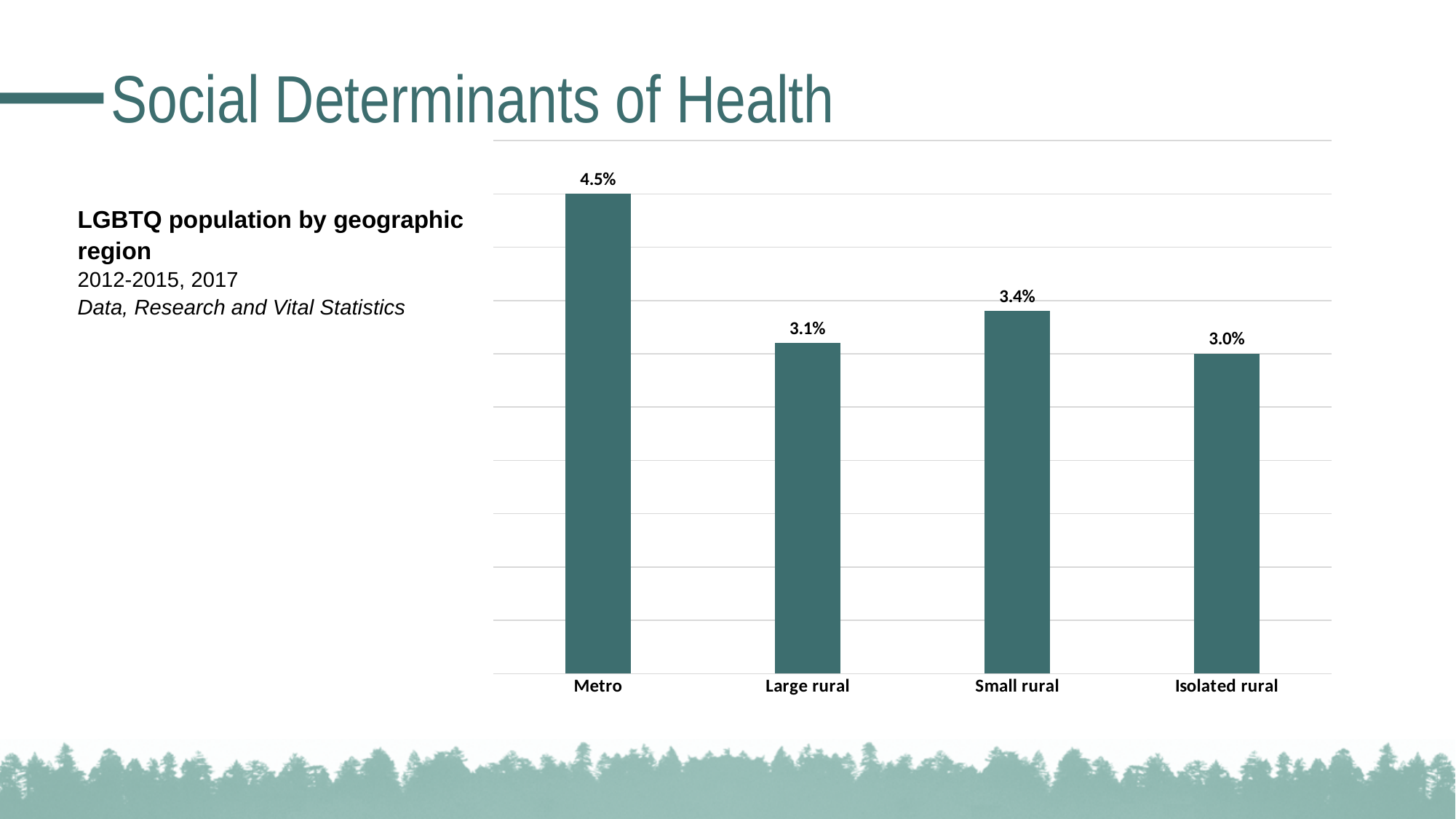
What is the difference between the Metro and Isolated rural percentages? 1.5% What is the LGBTQ population percentage for Metro? 4.5% Which geographic region has the lowest LGBTQ population percentage? Isolated rural How many geographic regions are shown in the chart? 4 Which geographic region has the highest LGBTQ population percentage? Metro What is the LGBTQ population percentage for Isolated rural? 3.0% What kind of chart is shown on the slide? Bar chart Which is larger, the value for Small rural or the value for Large rural? Small rural What is the LGBTQ population percentage for Large rural? 3.1% What is the title of the chart on the slide? LGBTQ population by geographic region What is the LGBTQ population percentage for Small rural? 3.4% What is the difference between the Small rural and Large rural percentages? 0.3%